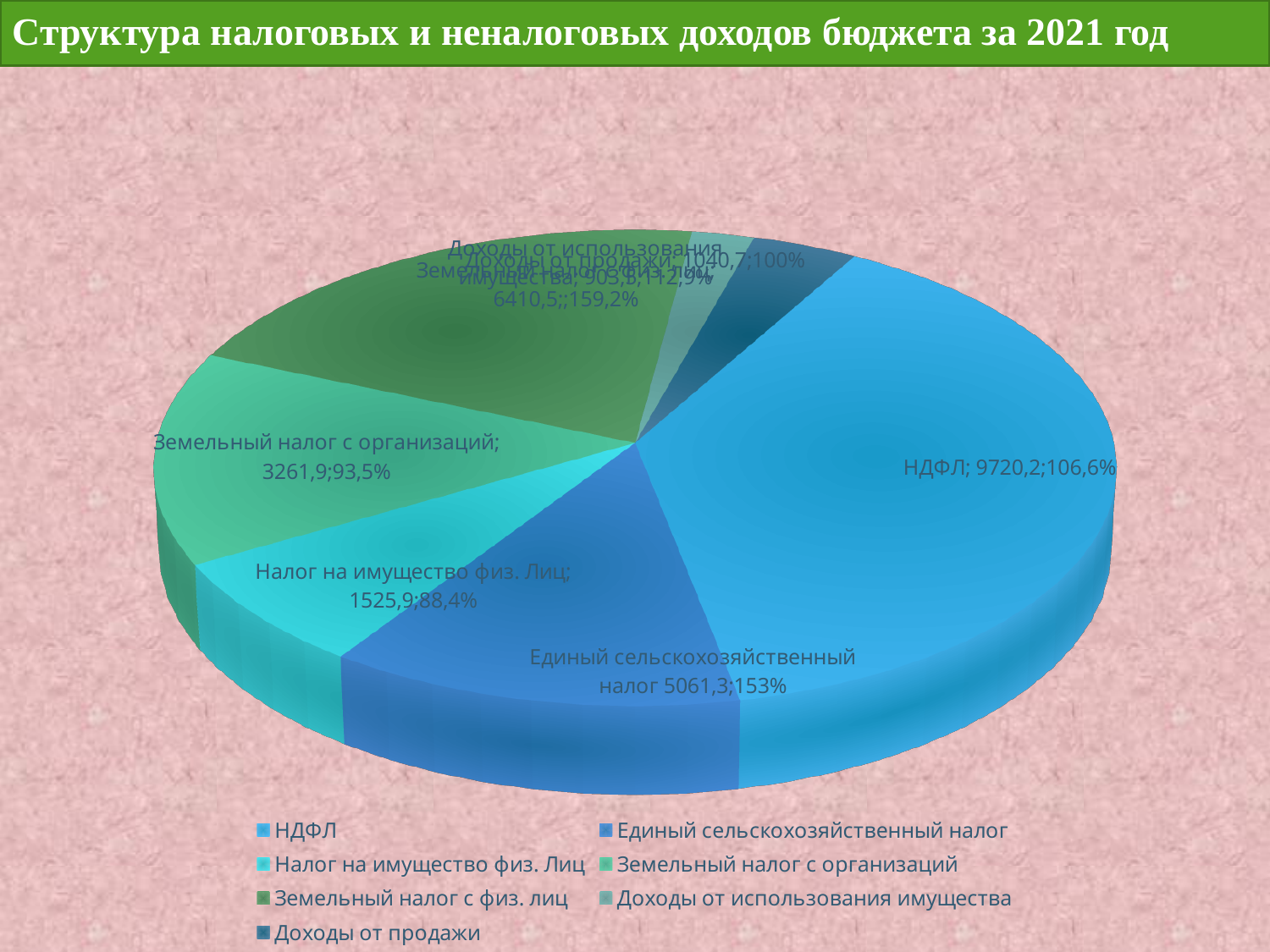
What is the value shown for Единый сельскохозяйственный налог? 5061,3 Which category has the largest slice of the pie? НДФЛ What is the difference between the values for НДФЛ and Единый сельскохозяйственный налог? 4658,9 What is the value shown for Налог на имущество физ. Лиц? 1525,9 What percentage is shown in the data label for НДФЛ? 106,6% What is the title of the slide? Структура налоговых и неналоговых доходов бюджета за 2021 год How many categories does the legend of the pie chart list? 7 What is the value shown for Земельный налог с организаций? 3261,9 What is the difference between the values for Земельный налог с организаций and Налог на имущество физ. Лиц? 1736 What kind of chart is shown on the slide? pie chart What is the value shown for НДФЛ? 9720,2